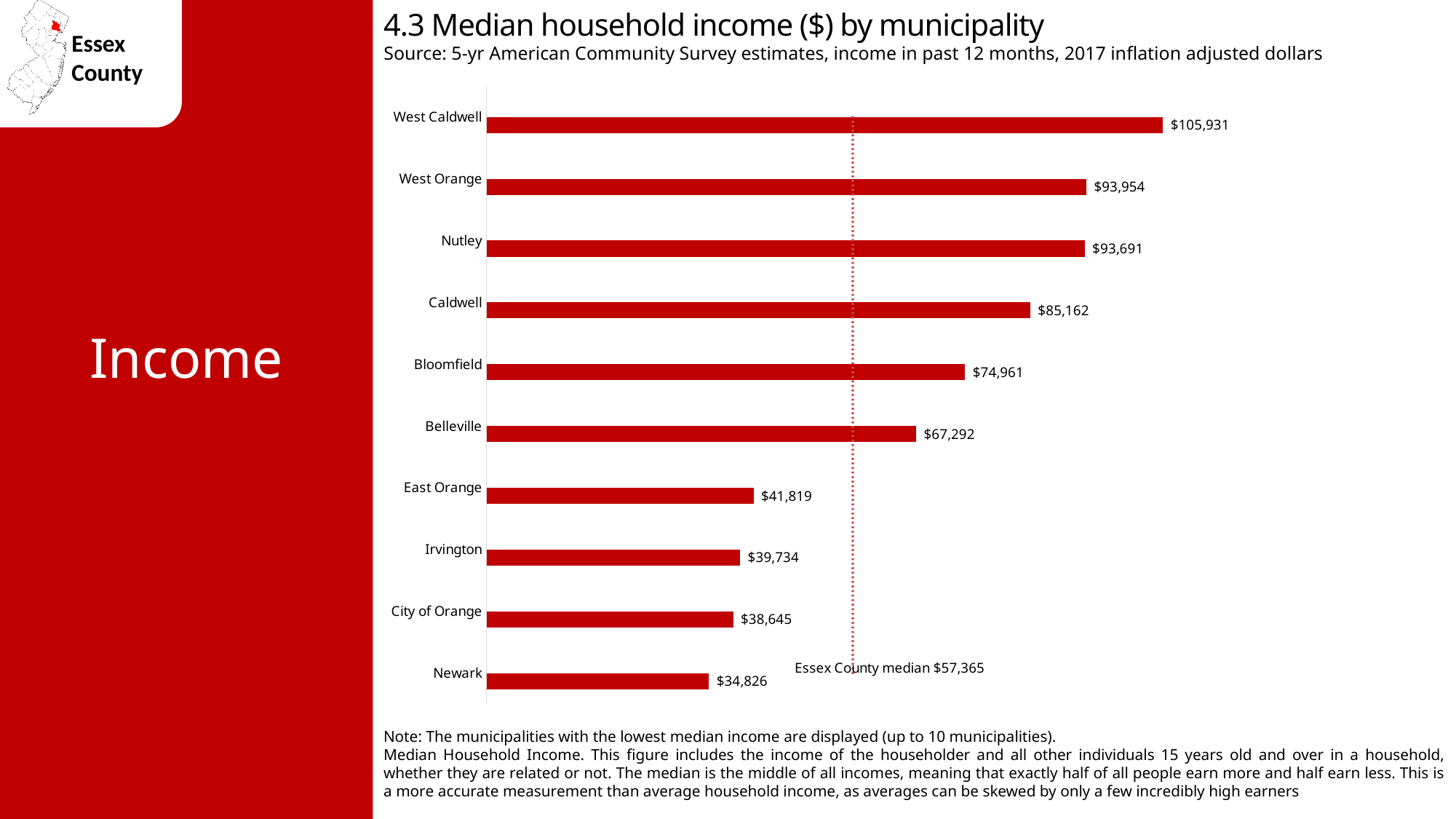
How many municipalities are shown on the chart? 10 What is the median household income for Bloomfield? $74,961 What is the median household income for Newark? $34,826 Which municipality has the lowest median household income on the chart? Newark What is the difference between the median household income of Caldwell and Bloomfield? $10,201 What is the median household income for West Caldwell? $105,931 What is the difference between the median household income of West Caldwell and Newark? $71,105 Do the median household income values increase or decrease going from the top bar to the bottom bar? Decrease Which has a higher median household income, Belleville or East Orange? Belleville What value does the dotted vertical line on the chart represent? Essex County median $57,365 What kind of chart is shown on the slide? Bar chart Which municipality has the highest median household income on the chart? West Caldwell